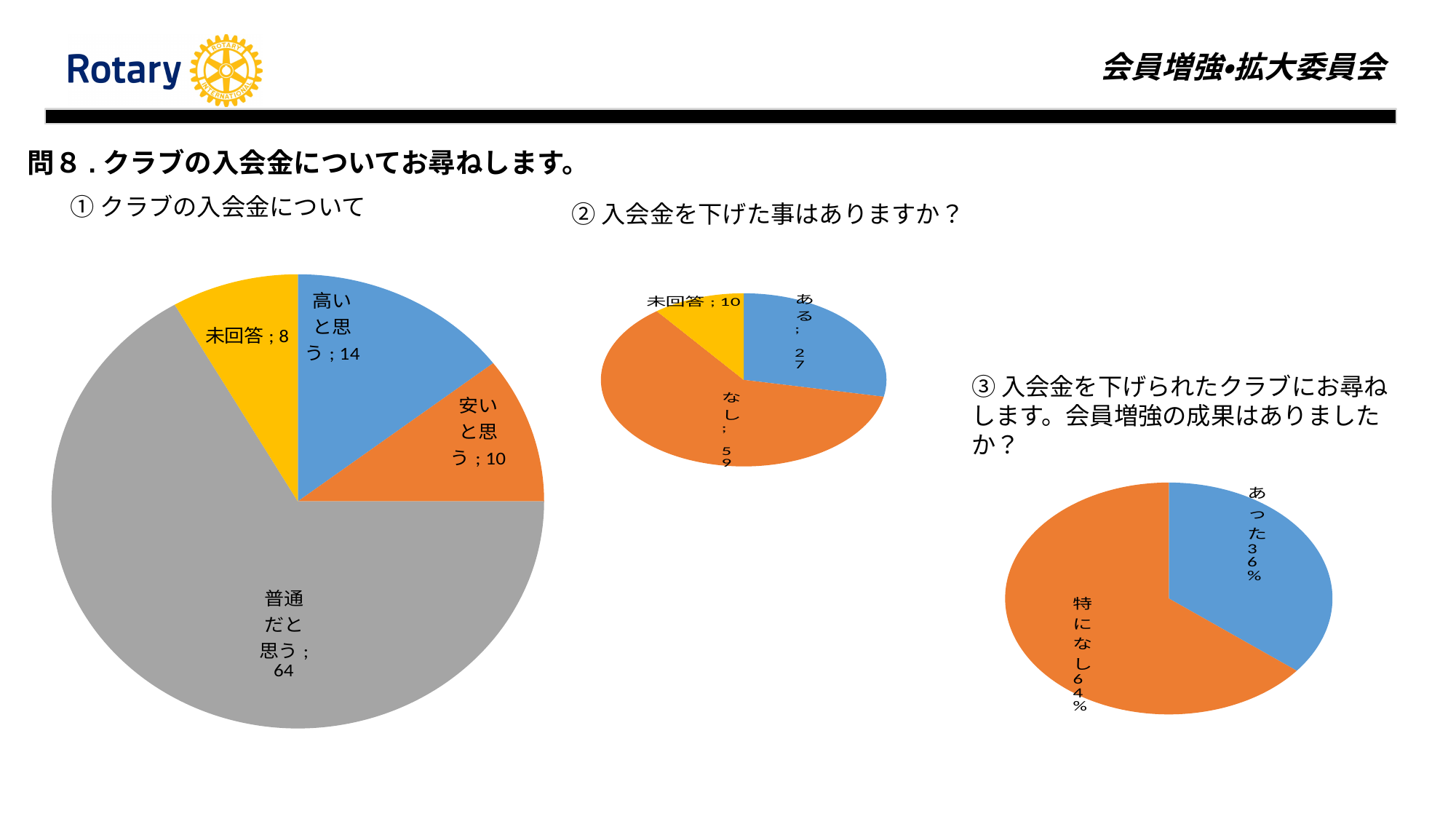
In the chart ② 入会金を下げた事はありますか？, which is larger, 未回答 or ある? ある In the chart ① クラブの入会金について, what is the difference between 高いと思う and 安いと思う? 4 In the chart ① クラブの入会金について, what is the value for 普通だと思う? 64 In the chart ① クラブの入会金について, what is the value for 高いと思う? 14 In the chart ① クラブの入会金について, how many categories are shown? 4 In the chart ① クラブの入会金について, which category has the smallest value? 未回答 In the chart ② 入会金を下げた事はありますか？, which category has the largest value? なし In the chart ③ 入会金を下げられたクラブにお尋ねします, what share does 特になし have? 64% In the chart ② 入会金を下げた事はありますか？, what is the value for ある? 27 What kind of chart is ① クラブの入会金について? Pie chart In the chart ② 入会金を下げた事はありますか？, what is the difference between なし and ある? 32 In the chart ③ 入会金を下げられたクラブにお尋ねします, how many categories are shown? 2